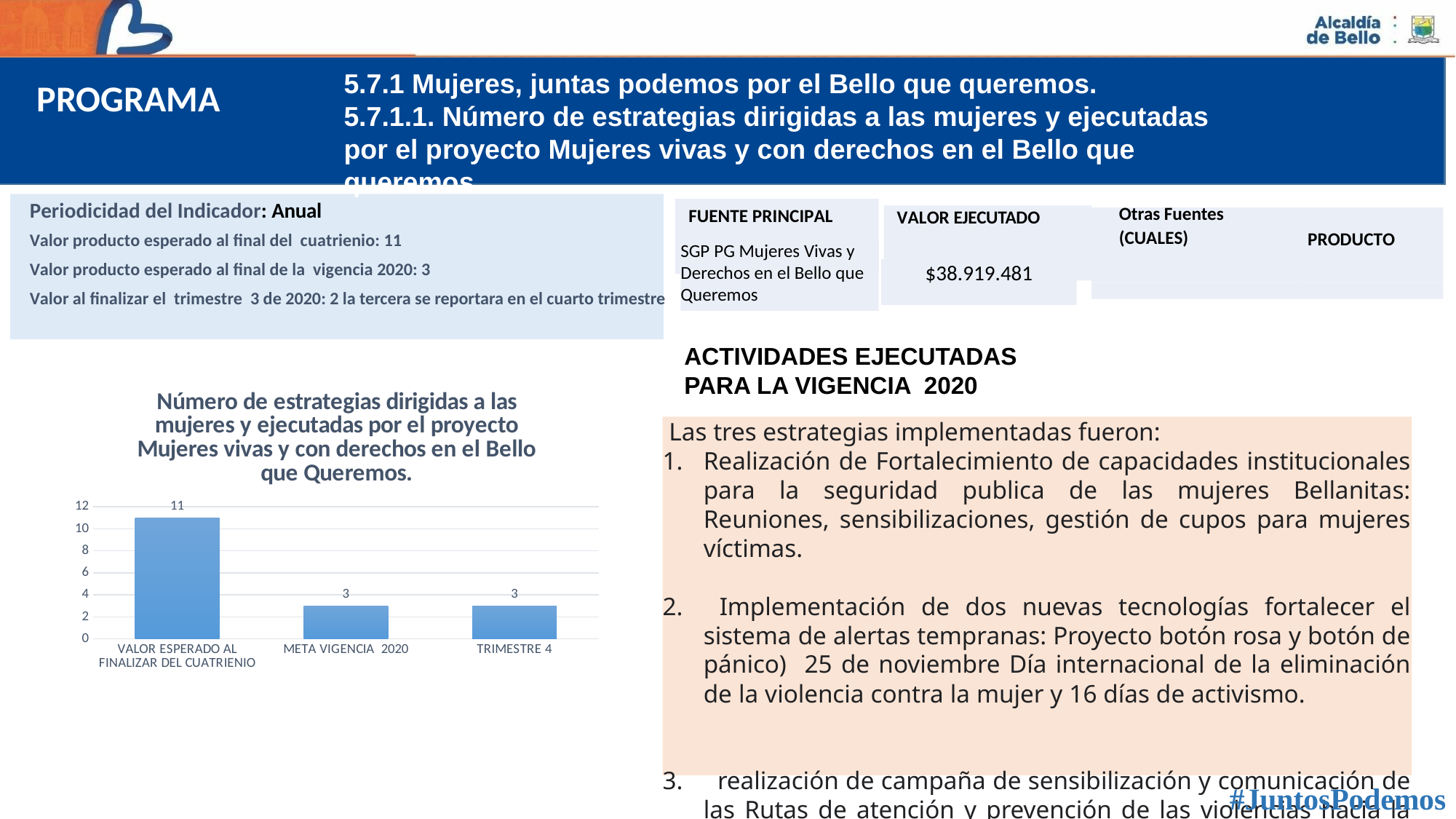
What is the value for TRIMESTRE 4? 3 What kind of chart is shown on the slide? bar chart What is the highest value shown on the chart's vertical axis? 12 Is the value for META VIGENCIA 2020 greater or less than 6? less Which category has the highest value? VALOR ESPERADO AL FINALIZAR DEL CUATRIENIO What is the value for VALOR ESPERADO AL FINALIZAR DEL CUATRIENIO? 11 What is the difference between the value for VALOR ESPERADO AL FINALIZAR DEL CUATRIENIO and the value for META VIGENCIA 2020? 8 Is the value for VALOR ESPERADO AL FINALIZAR DEL CUATRIENIO greater or less than 10? greater Which is larger, the value for VALOR ESPERADO AL FINALIZAR DEL CUATRIENIO or the value for TRIMESTRE 4? VALOR ESPERADO AL FINALIZAR DEL CUATRIENIO What is the value for META VIGENCIA 2020? 3 How many categories are shown on the chart? 3 Do the values rise or fall from the first category to the last along the x axis? fall